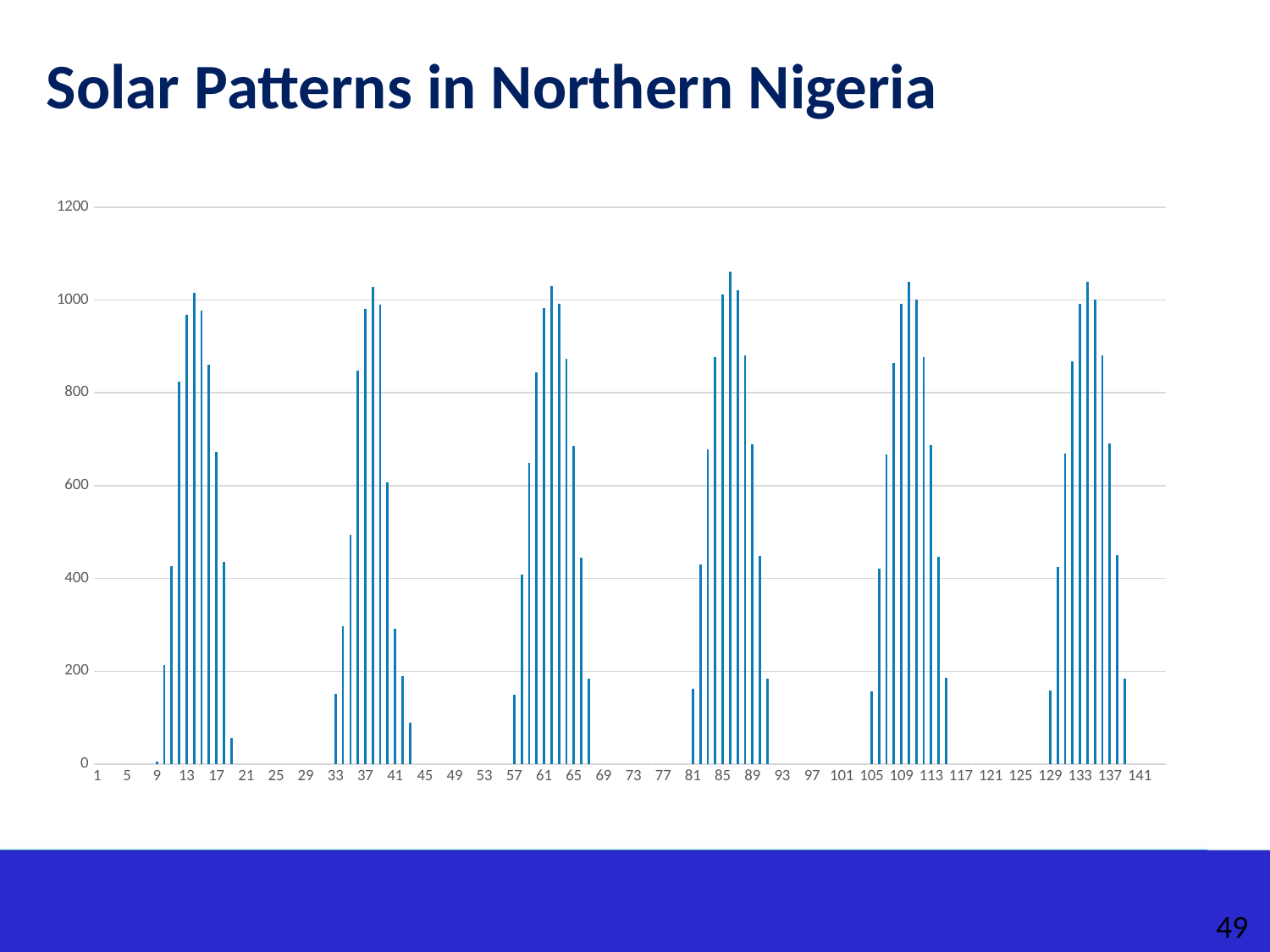
Is the value for category 85 greater or less than 800? greater Is the value for category 61 greater or less than 600? greater Is the value for category 25 greater or less than 200? less How many separate clusters of bars (peaks) appear along the x axis? 6 What is the highest value labelled on the y axis? 1200 What kind of chart is shown on the slide? bar chart